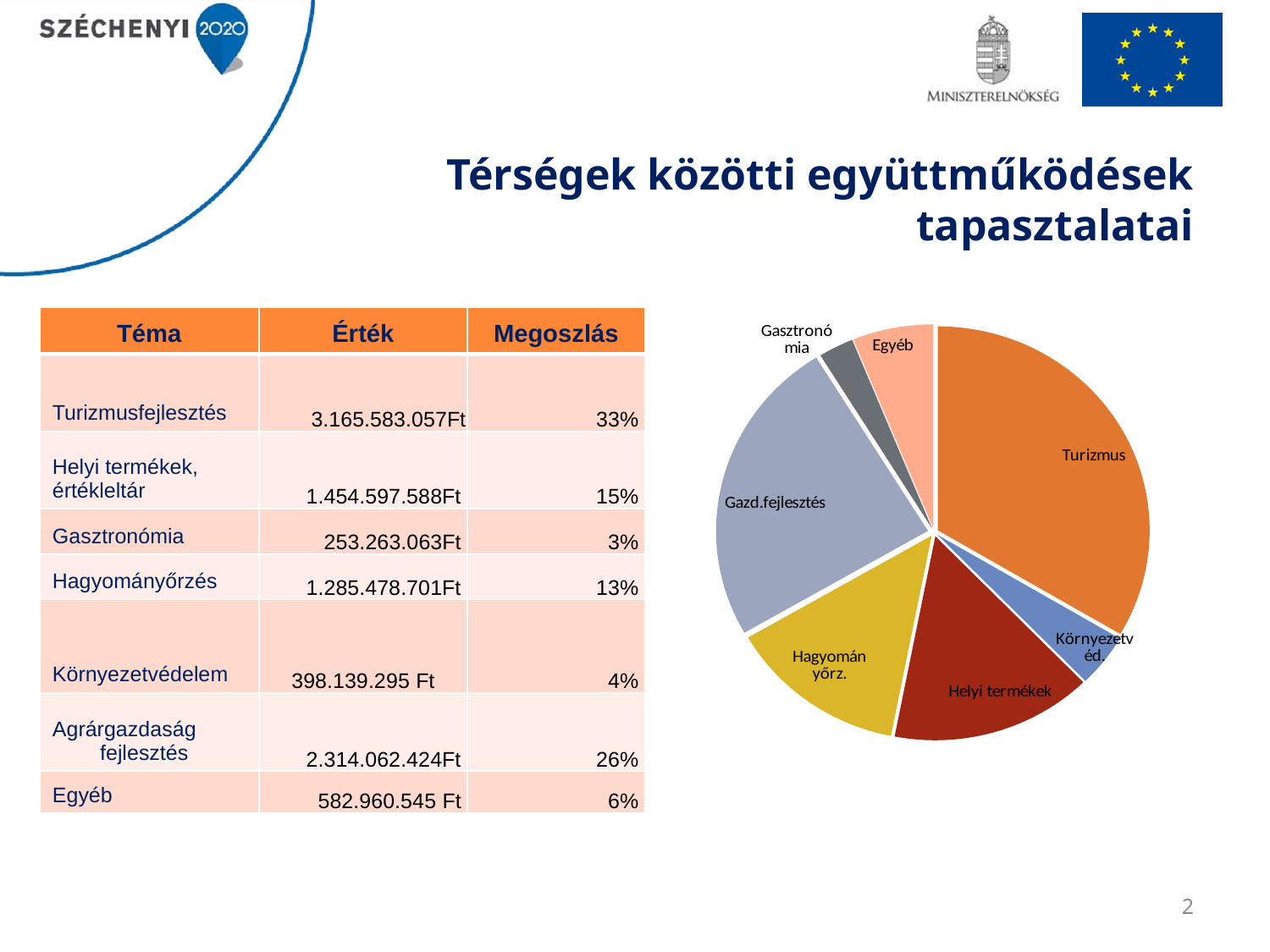
Which slice is larger in the pie chart, Hagyományőrz. or Környezetvéd.? Hagyományőrz. Which slice of the pie chart is the smallest? Gasztronómia Which slice of the pie chart is the largest? Turizmus According to the table on the slide, what share of the pie does the Egyéb slice represent? 6% What colour is the Turizmus slice in the pie chart? orange Which slice is larger in the pie chart, Gazd.fejlesztés or Helyi termékek? Gazd.fejlesztés What colour is the Hagyományőrz. slice in the pie chart? yellow How many slices does the pie chart have? 7 According to the table on the slide, what share of the pie does the Turizmus slice represent? 33% What kind of chart is shown on the slide? pie chart According to the table on the slide, what share of the pie does the Gasztronómia slice represent? 3% Which slice is larger in the pie chart, Egyéb or Gasztronómia? Egyéb